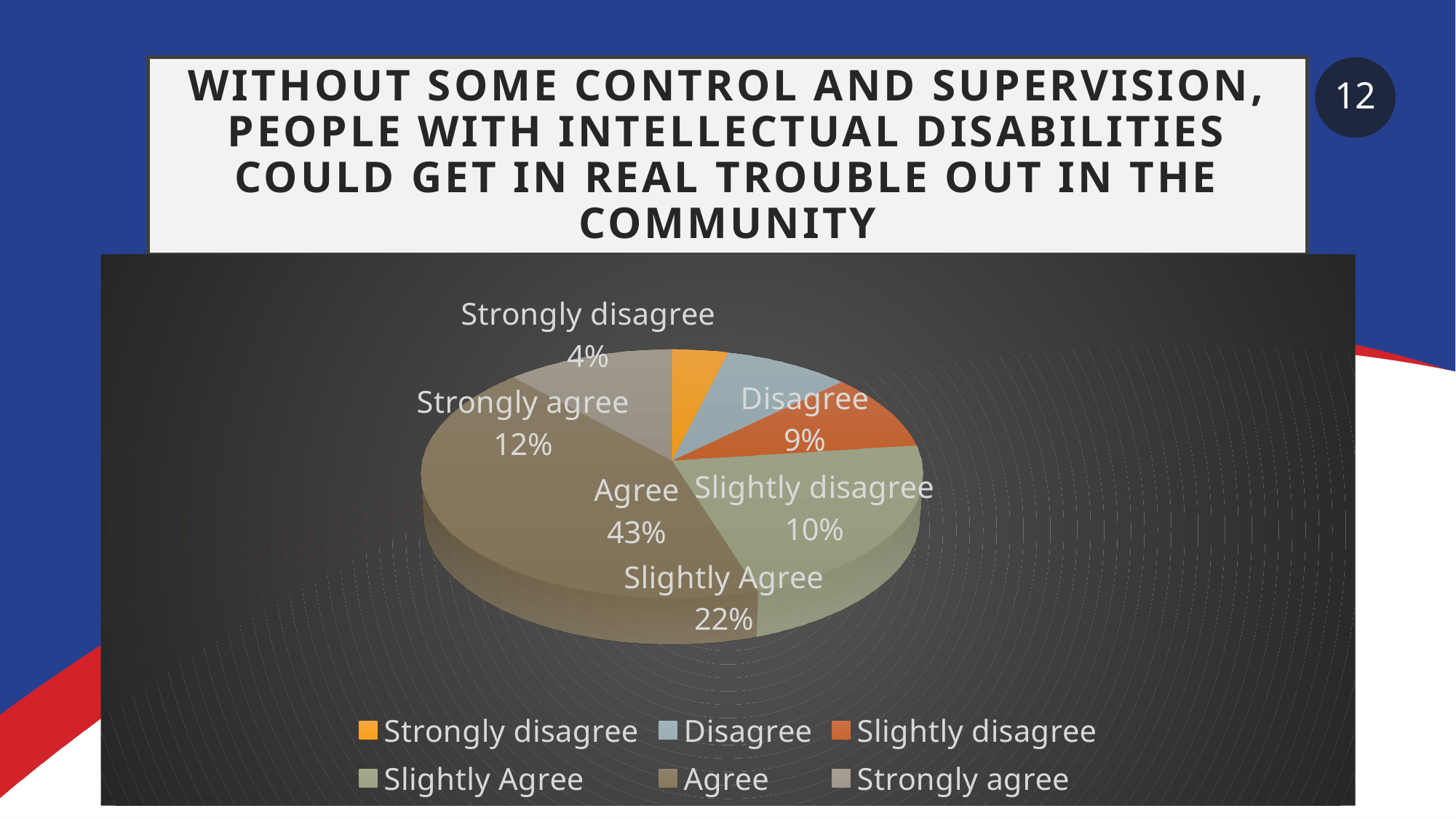
What percentage of respondents chose "Strongly disagree"? 4% Which response category has the largest share of the pie? Agree Which is larger, the share for "Strongly agree" or the share for "Slightly disagree"? Strongly agree Which response category has the smallest share of the pie? Strongly disagree What percentage of respondents chose "Slightly Agree"? 22% What kind of chart is shown on the slide? pie chart What percentage of respondents chose "Agree"? 43% What percentage of respondents chose "Disagree"? 9% Which colour represents "Strongly disagree" in the legend? orange/yellow What percentage of respondents chose "Strongly agree"? 12% What is the difference in percentage points between "Agree" and "Slightly Agree"? 21 How many response categories does the pie chart show? 6